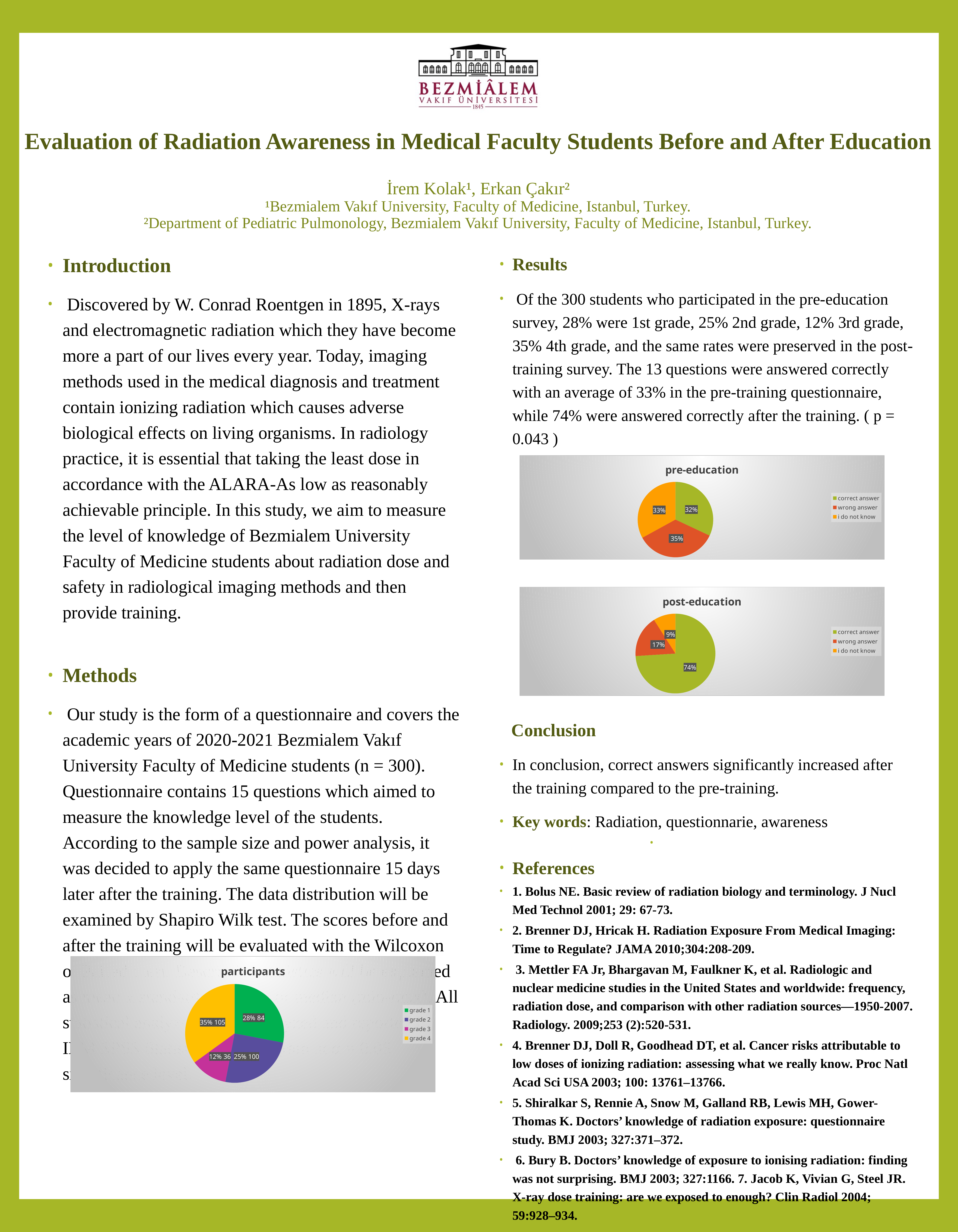
In the post-education chart, which category has the smallest share? i do not know What type of chart is the post-education chart? pie chart In the participants chart, what percentage of participants were grade 4? 35% In the pre-education chart, what percentage of answers were 'i do not know'? 33% In the pre-education chart, which category has the largest share? wrong answer In the pre-education chart, what percentage of answers were correct? 32% In the post-education chart, what percentage of answers were wrong? 17% In the participants chart, which grade has the smallest share? grade 3 What is the difference in the correct answer percentage between the post-education and pre-education charts? 42% How many categories does the participants chart show? 4 How many entries does the legend of the pre-education chart list? 3 In the post-education chart, what percentage of answers were correct? 74%